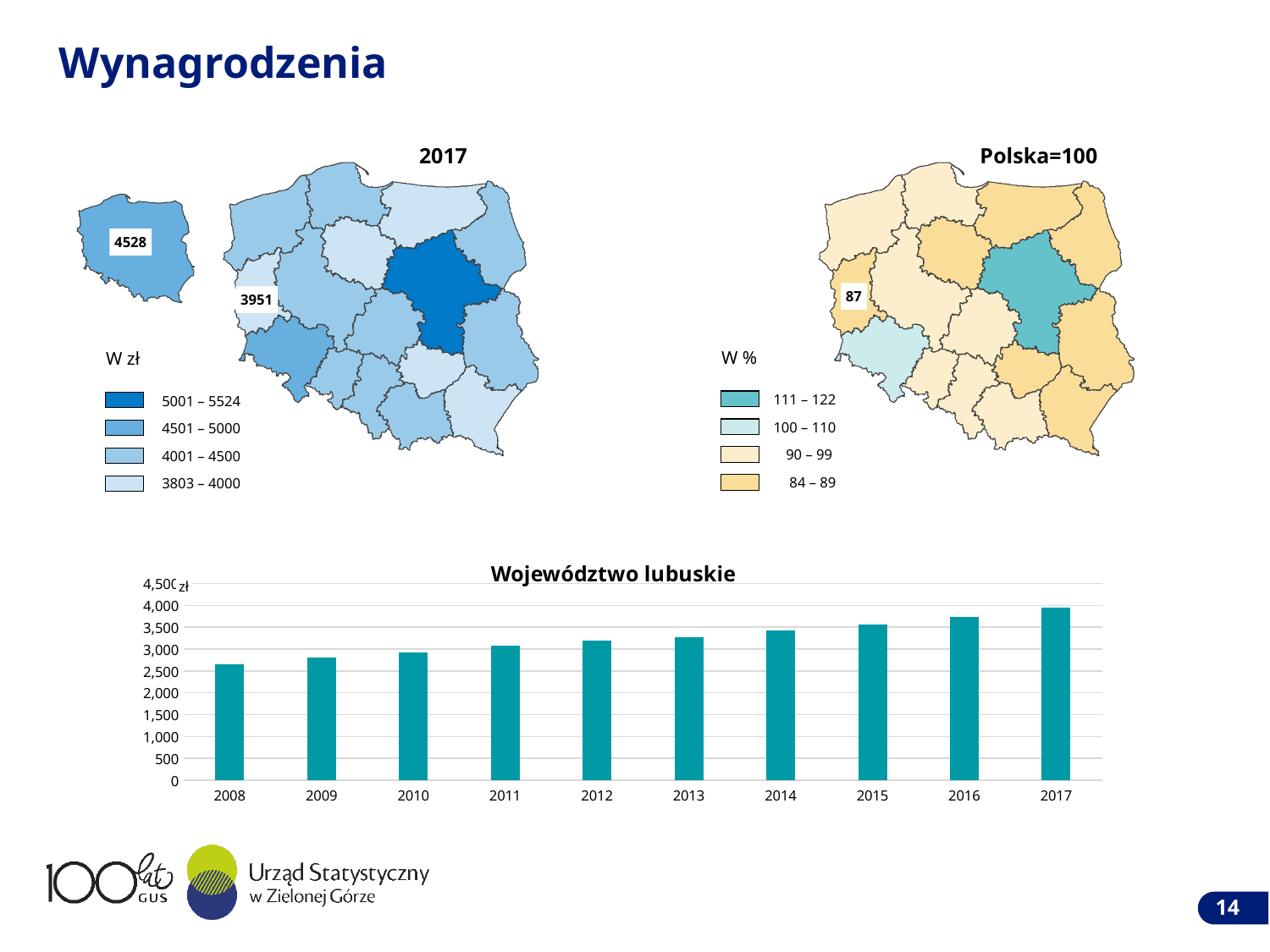
In the 'Województwo lubuskie' bar chart, which year has the lowest value? 2008 In the 'Województwo lubuskie' bar chart, is the value for 2016 greater or less than 3,500? greater In the 'Województwo lubuskie' bar chart, which year has the larger value, 2009 or 2015? 2015 In the 'Województwo lubuskie' bar chart, is the value for 2017 greater or less than 3,500? greater How many years are shown on the x axis of the 'Województwo lubuskie' bar chart? 10 In the 'Województwo lubuskie' bar chart, do the values rise or fall from 2008 to 2017? rise In the 'Województwo lubuskie' bar chart, is the value for 2012 greater or less than 3,000? greater In the 'Województwo lubuskie' bar chart, which year has the highest value? 2017 What unit is shown at the top of the y axis of the 'Województwo lubuskie' bar chart? zł What is the title of the bar chart at the bottom of the slide? Województwo lubuskie What kind of chart is the 'Województwo lubuskie' chart at the bottom of the slide? bar chart